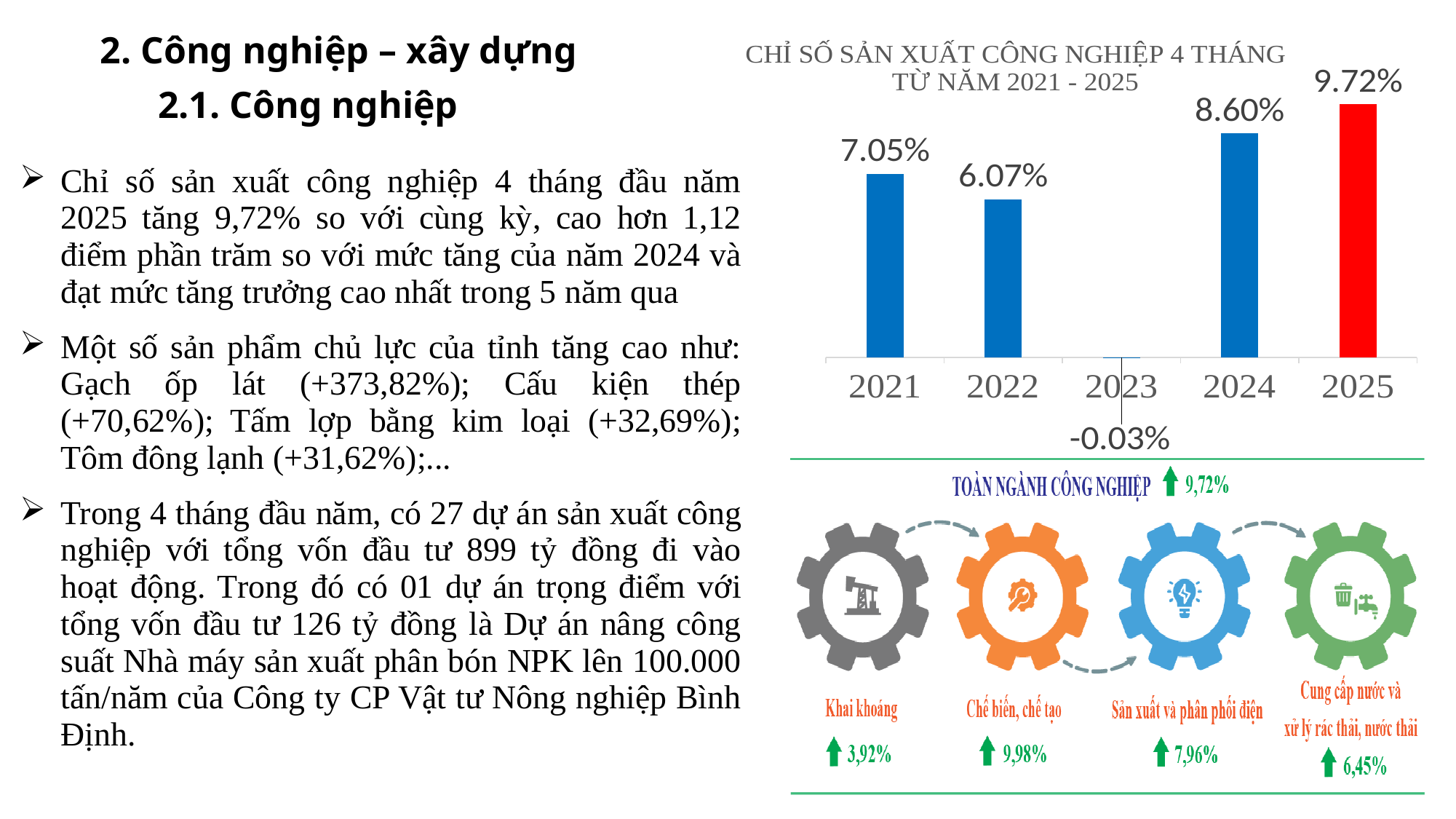
What kind of chart is shown on the slide? Bar chart Which is larger, the value for 2021 or the value for 2022? 2021 What is the difference between the values for 2021 and 2022? 0.98 percentage points Which year has the lowest value in the chart? 2023 What is the value for 2025 in the chart? 9.72% What is the value for 2021 in the chart? 7.05% What is the difference between the values for 2025 and 2024? 1.12 percentage points What is the value for 2023 in the chart? -0.03% How many years are shown on the x axis of the chart? 5 Which bar in the chart is coloured red rather than blue? 2025 Which year has the highest value in the chart? 2025 What is the value for 2022 in the chart? 6.07%